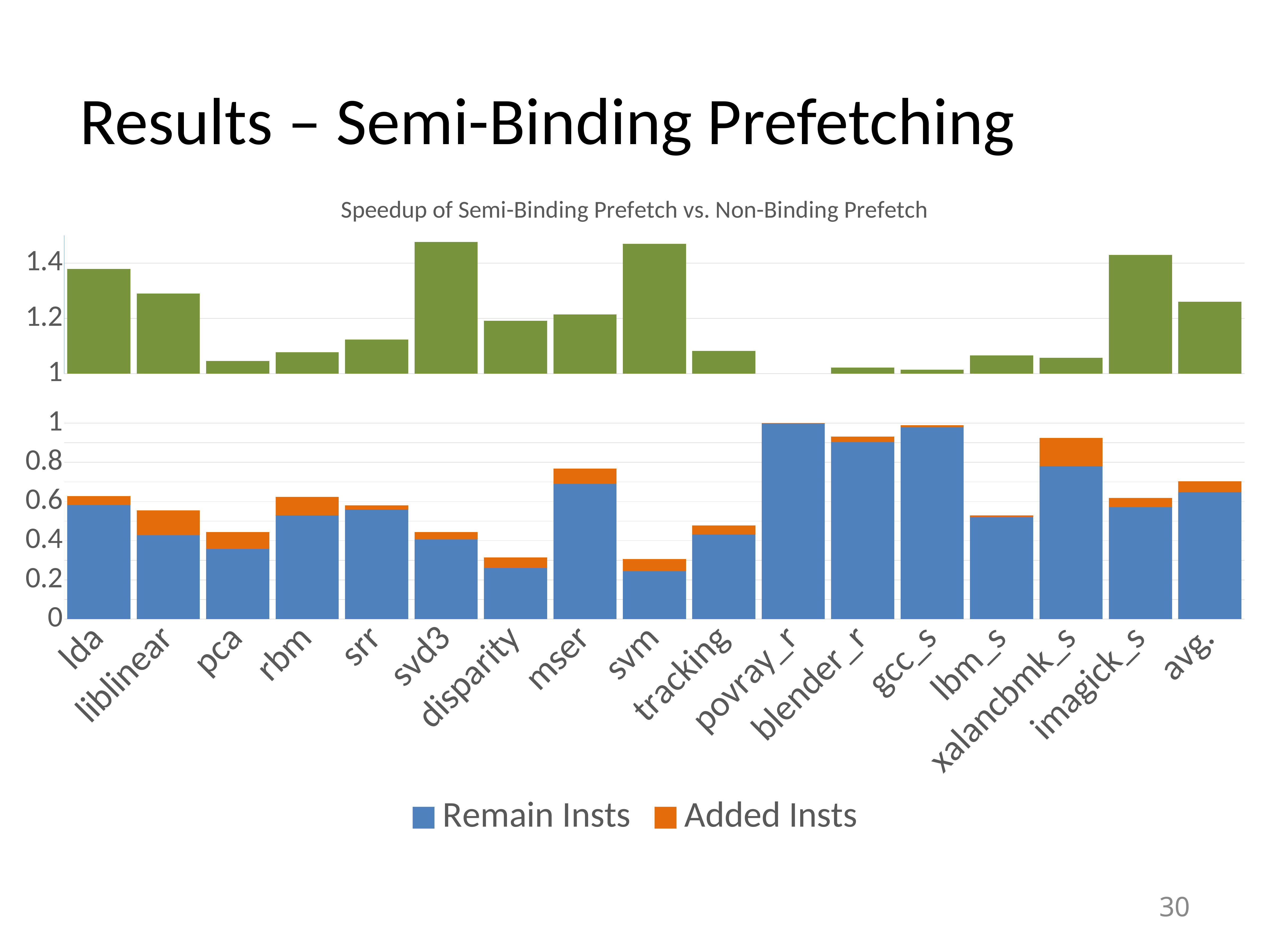
In the bottom chart, how many categories are shown on the x axis? 17 What kind of chart is the top chart? bar chart In the bottom chart, is the Remain Insts value for svm greater or less than 0.4? less In the bottom chart, what are the two legend entries? Remain Insts, Added Insts In the bottom chart, how many series does the legend list? 2 In the top chart, which is larger, the value for lda or the value for pca? lda In the top chart, is the value for povray_r greater or less than 1.2? less In the top chart, what is the chart title? Speedup of Semi-Binding Prefetch vs. Non-Binding Prefetch In the top chart, is the value for lda greater or less than 1.2? greater In the bottom chart, which is larger, the Remain Insts value for mser or the Remain Insts value for lda? mser